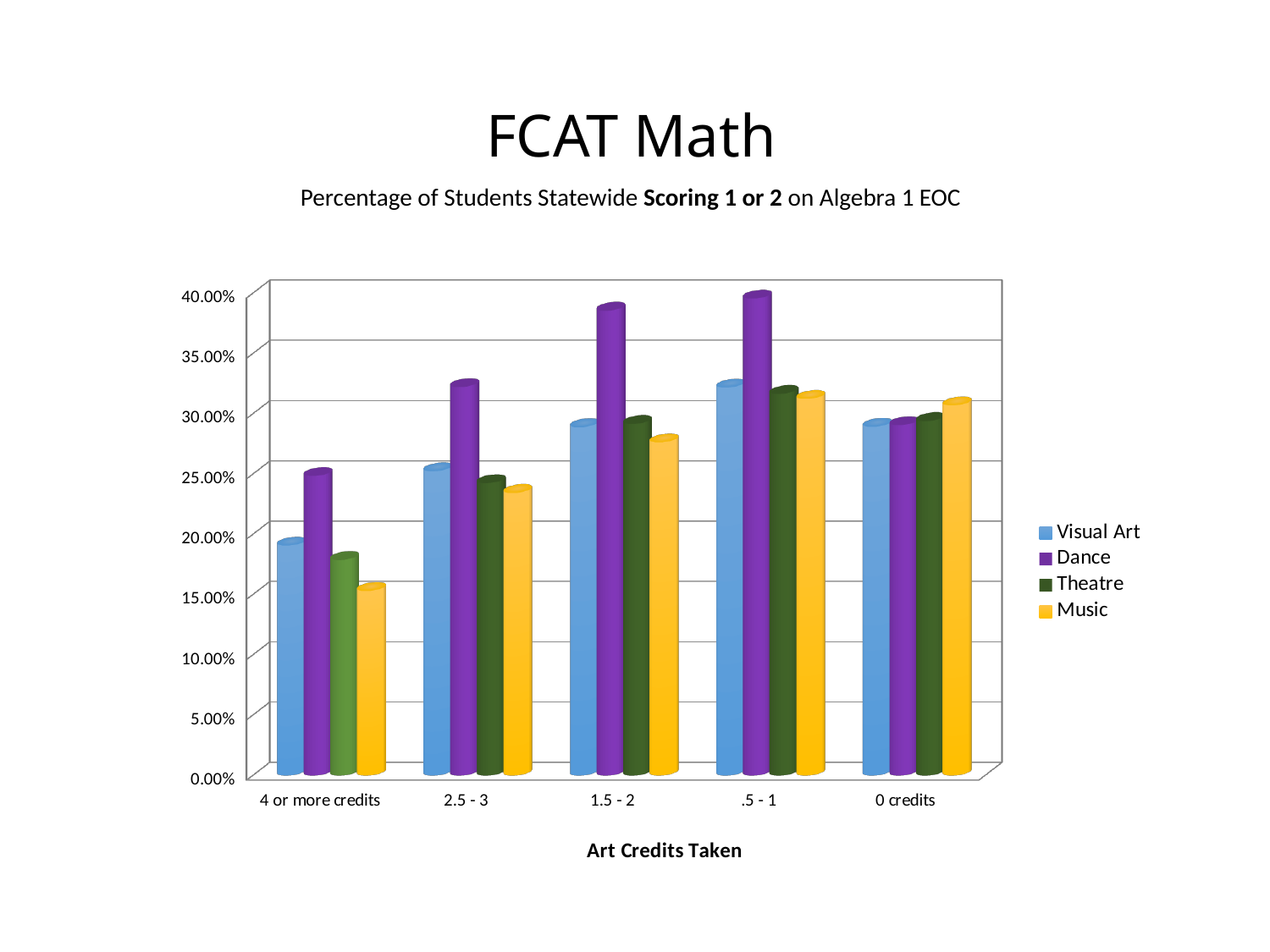
Which series has the lowest value for the 4 or more credits category? Music What is the title of the x axis? Art Credits Taken Which series is represented by the purple bars? Dance Which series has the highest value for the 4 or more credits category? Dance What kind of chart is shown on the slide? bar chart Is the value for Visual Art at 2.5 - 3 credits greater or less than 20.00%? greater How many categories are shown on the x axis? 5 For which category is the Dance value lowest? 4 or more credits Is the value for Dance at .5 - 1 credits greater or less than 35.00%? greater Is the value for Music at 4 or more credits greater or less than 20.00%? less Which is larger for the 2.5 - 3 category, Dance or Music? Dance How many series does the legend list? 4